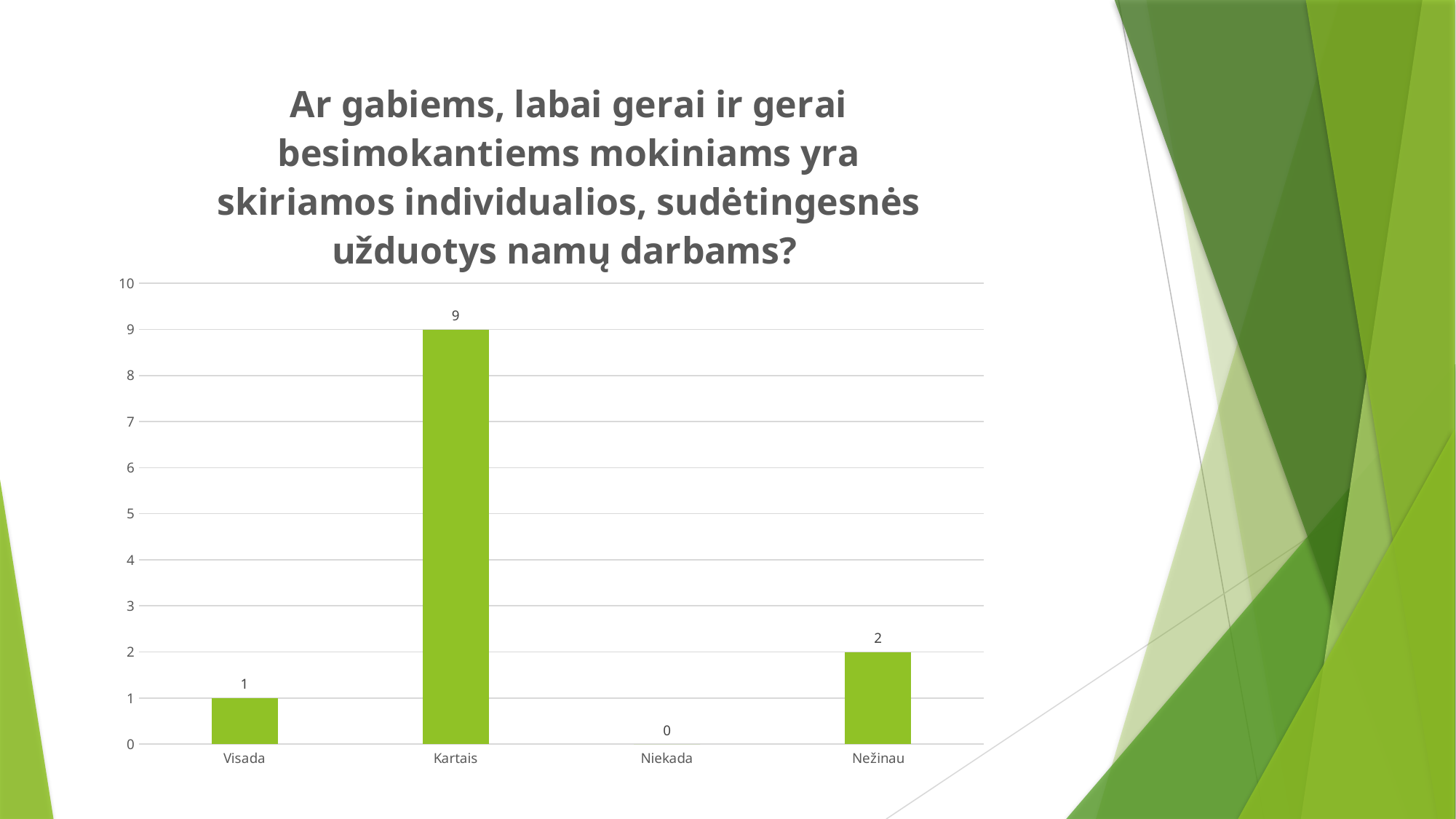
Which is larger, the value for Visada or the value for Nežinau? Nežinau What is the value for Visada? 1 Which category has the lowest value? Niekada What is the value for Kartais? 9 How many categories are shown on the x axis? 4 What is the value for Niekada? 0 What is the total of all four values shown in the chart? 12 What is the value for Nežinau? 2 What kind of chart is shown on the slide? bar chart What is the difference between the values for Kartais and Nežinau? 7 Is the value for Kartais greater or less than 5? greater Which category has the highest value? Kartais